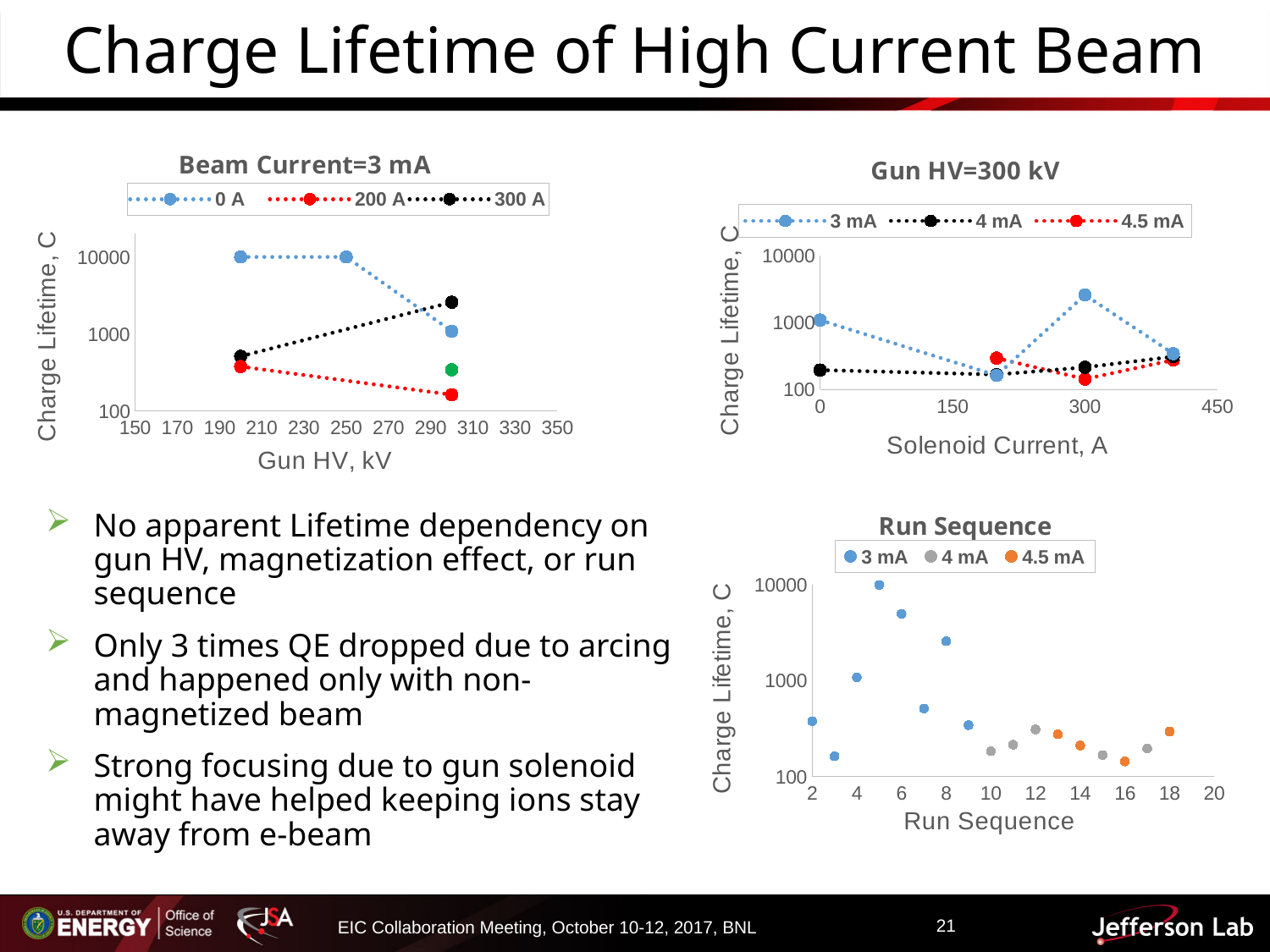
How many series does the legend of the Gun HV=300 kV chart list? 3 In the Beam Current=3 mA chart, at 300 kV, which series has the larger charge lifetime: 200 A or 300 A? 300 A How many series does the legend of the Beam Current=3 mA chart list? 3 In the Run Sequence chart, which run sequence number has the highest charge lifetime? 5 In the Beam Current=3 mA chart, is the charge lifetime for the 200 A series at 300 kV greater or less than 1000? less In the Beam Current=3 mA chart, is the charge lifetime for the 0 A series at 200 kV greater or less than 1000? greater What is the x-axis label of the Gun HV=300 kV chart? Solenoid Current, A What kind of chart is the Run Sequence chart? scatter chart In the Gun HV=300 kV chart, is the charge lifetime for the 3 mA series at a solenoid current of 300 A greater or less than 1000? greater In the Beam Current=3 mA chart, does the 200 A series rise or fall from 200 kV to 300 kV? fall What are the legend entries of the Gun HV=300 kV chart? 3 mA, 4 mA, 4.5 mA In the Gun HV=300 kV chart, at a solenoid current of 300 A, which series has the larger charge lifetime: 3 mA or 4 mA? 3 mA